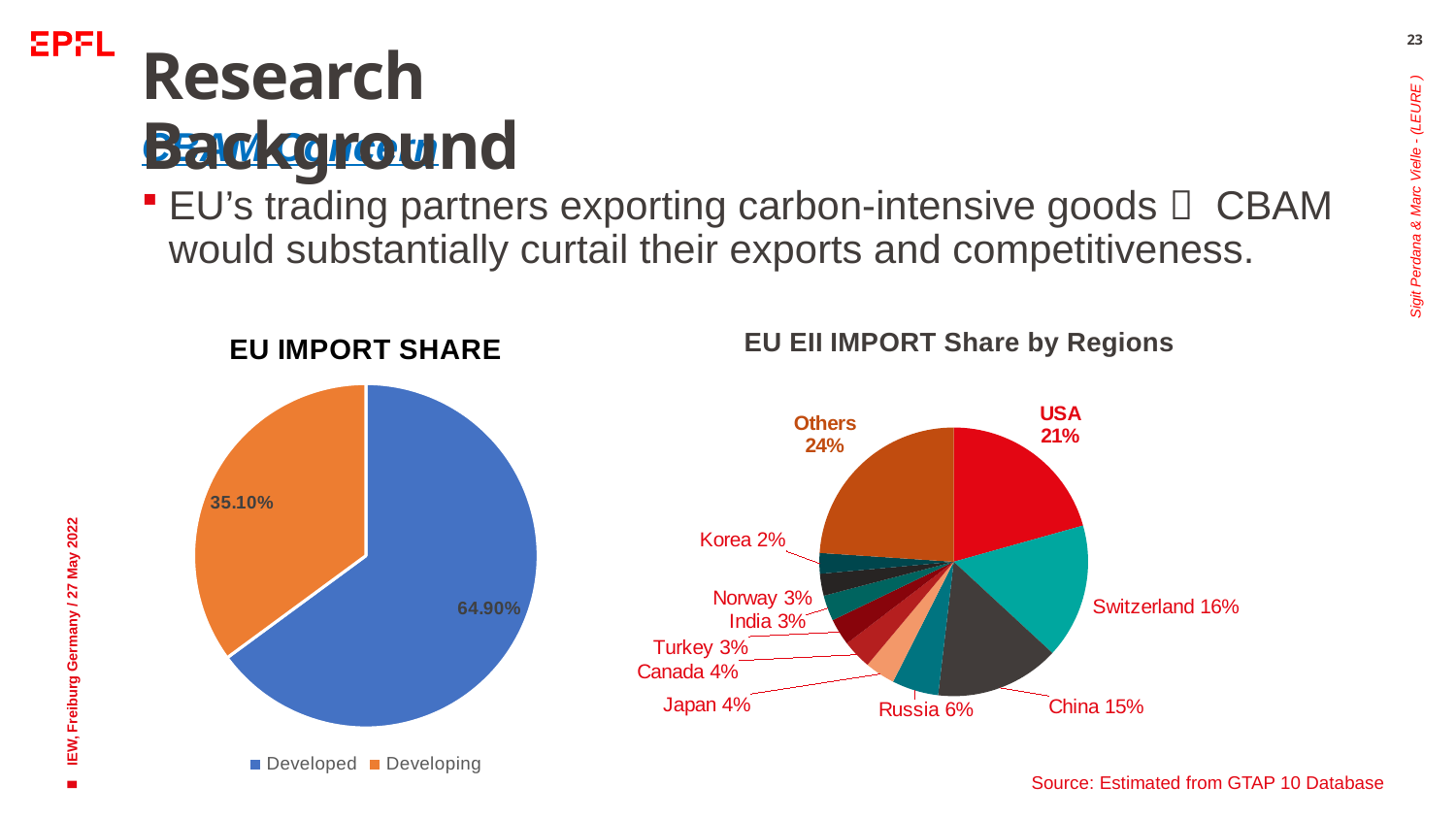
In the EU IMPORT SHARE chart, which category has the larger share, Developed or Developing? Developed In the EU EII IMPORT Share by Regions chart, what share is shown for the USA? 21% In the EU EII IMPORT Share by Regions chart, what is the difference between the shares of China and Russia? 9% In the EU IMPORT SHARE chart, what share is shown for Developed? 64.90% In the EU IMPORT SHARE chart, what is the difference between the Developed and Developing shares? 29.80% In the EU EII IMPORT Share by Regions chart, which named country has the smallest share? Korea In the EU EII IMPORT Share by Regions chart, which slice is the largest? Others How many entries does the legend of the EU IMPORT SHARE chart list? 2 In the EU EII IMPORT Share by Regions chart, what share is shown for Switzerland? 16% How many slices does the EU EII IMPORT Share by Regions pie chart have? 11 What kind of chart is the EU IMPORT SHARE chart? Pie chart In the EU IMPORT SHARE chart, what share is shown for Developing? 35.10%